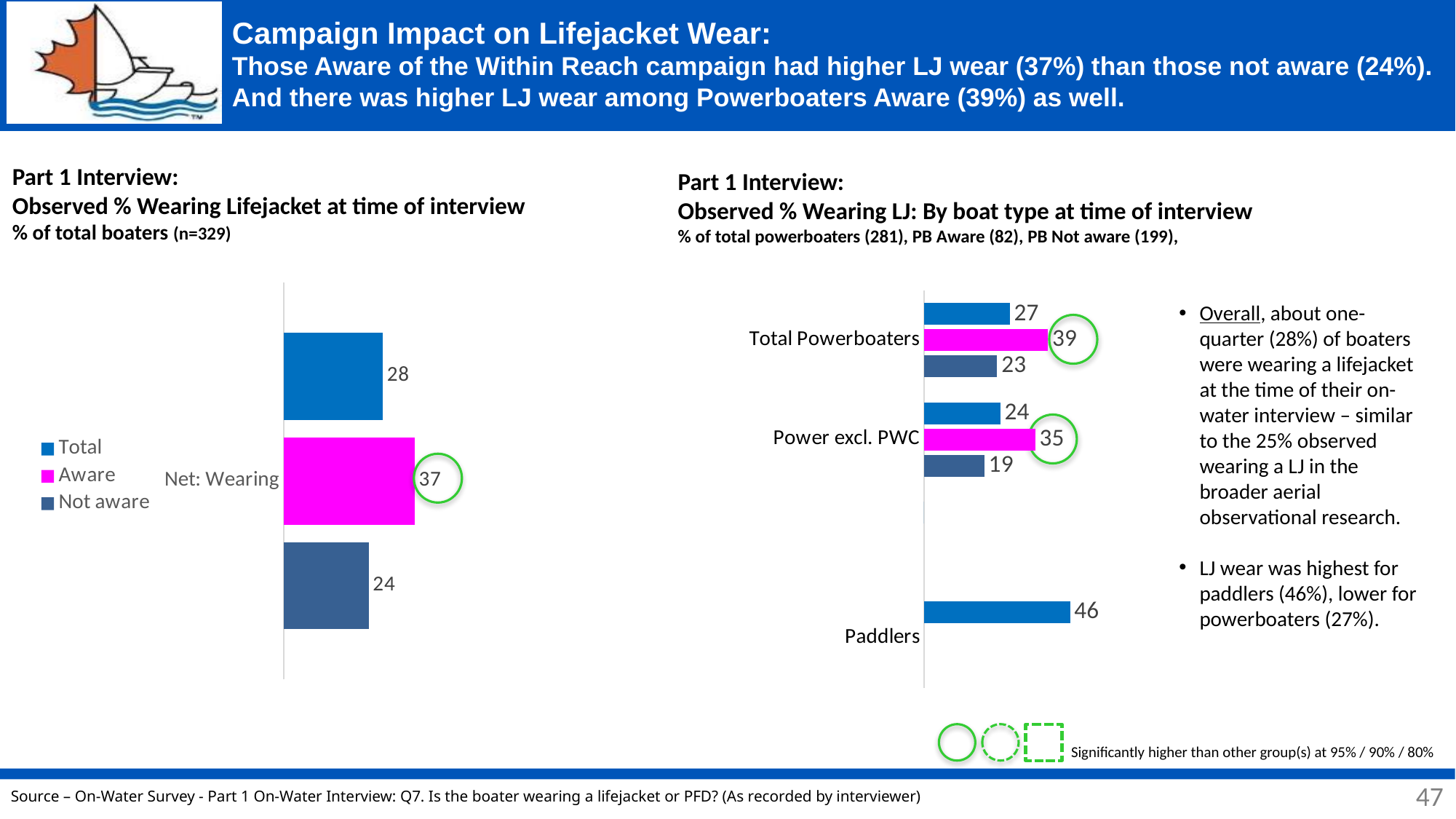
In the left chart (Observed % Wearing Lifejacket at time of interview), what is the value for the Aware series? 37 In the right chart (Observed % Wearing LJ: By boat type), which is larger for Power excl. PWC: the Aware value or the Not aware value? Aware In the right chart (Observed % Wearing LJ: By boat type), what is the difference between the Aware and Not aware values for Total Powerboaters? 16 In the right chart (Observed % Wearing LJ: By boat type), what is the Total value for Paddlers? 46 In the left chart (Observed % Wearing Lifejacket at time of interview), how many series does the legend list? 3 In the left chart (Observed % Wearing Lifejacket at time of interview), what is the value for the Not aware series? 24 In the right chart (Observed % Wearing LJ: By boat type), what is the Not aware value for Power excl. PWC? 19 In the right chart (Observed % Wearing LJ: By boat type), how many boat type categories are shown? 3 In the right chart (Observed % Wearing LJ: By boat type), which category has the highest Total value? Paddlers In the right chart (Observed % Wearing LJ: By boat type), what is the Aware value for Total Powerboaters? 39 In the left chart (Observed % Wearing Lifejacket at time of interview), what is the difference between the Aware and Not aware values? 13 In the left chart (Observed % Wearing Lifejacket at time of interview), what kind of chart is it? Bar chart